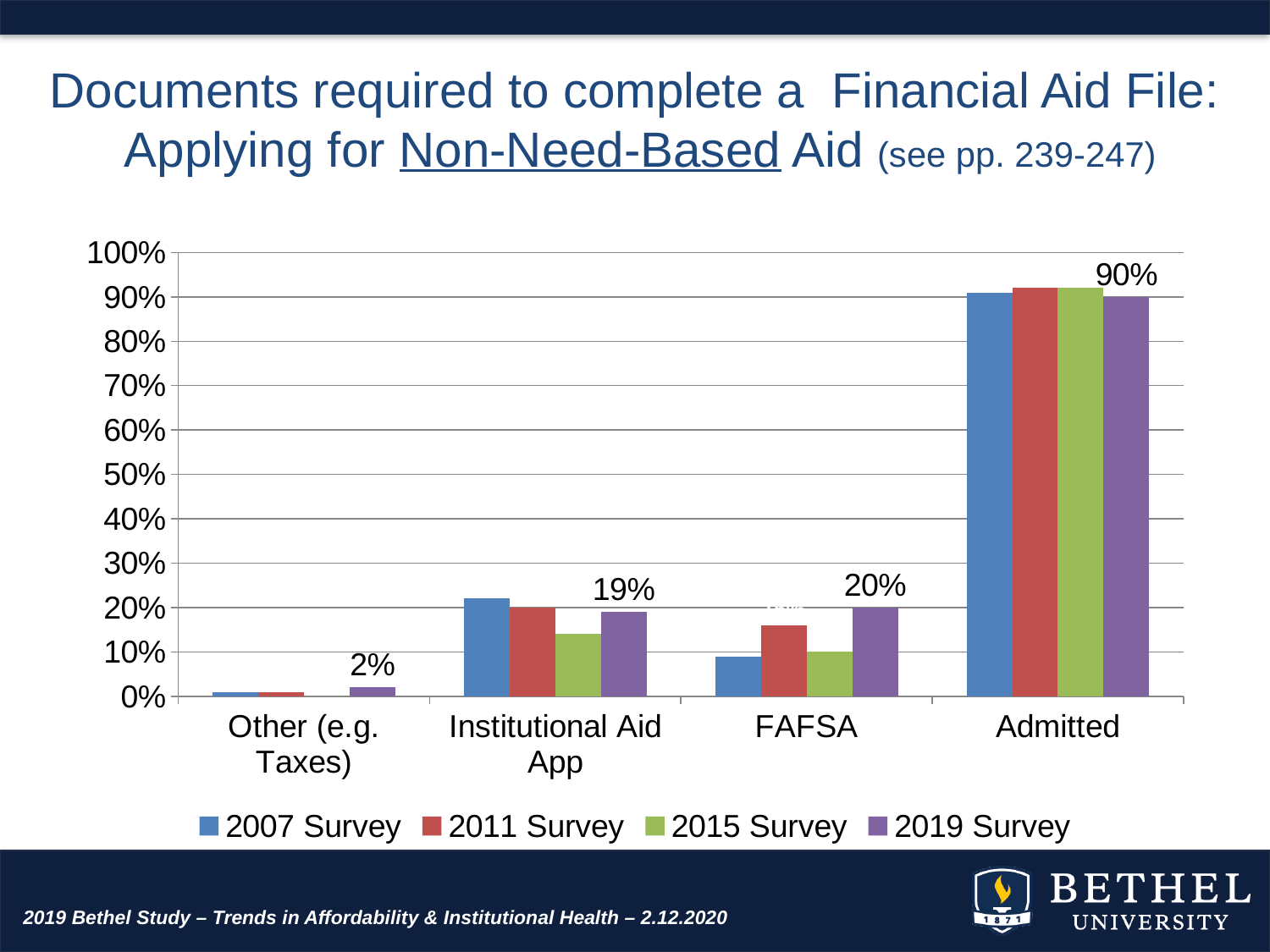
What is the 2019 Survey value for FAFSA? 20% What kind of chart is shown on the slide? Bar chart Which category has the lowest 2019 Survey value? Other (e.g. Taxes) How many series does the legend list? 4 What is the 2019 Survey value for Institutional Aid App? 19% Is the 2011 Survey value for Admitted greater or less than 80%? greater What is the difference between the 2019 Survey values for Admitted and Other (e.g. Taxes)? 88 percentage points Which is larger for the 2019 Survey: FAFSA or Institutional Aid App? FAFSA Which category has the highest 2019 Survey value? Admitted What is the 2019 Survey value for Admitted? 90% What is the 2019 Survey value for Other (e.g. Taxes)? 2% Is the 2015 Survey value for Institutional Aid App greater or less than 20%? less